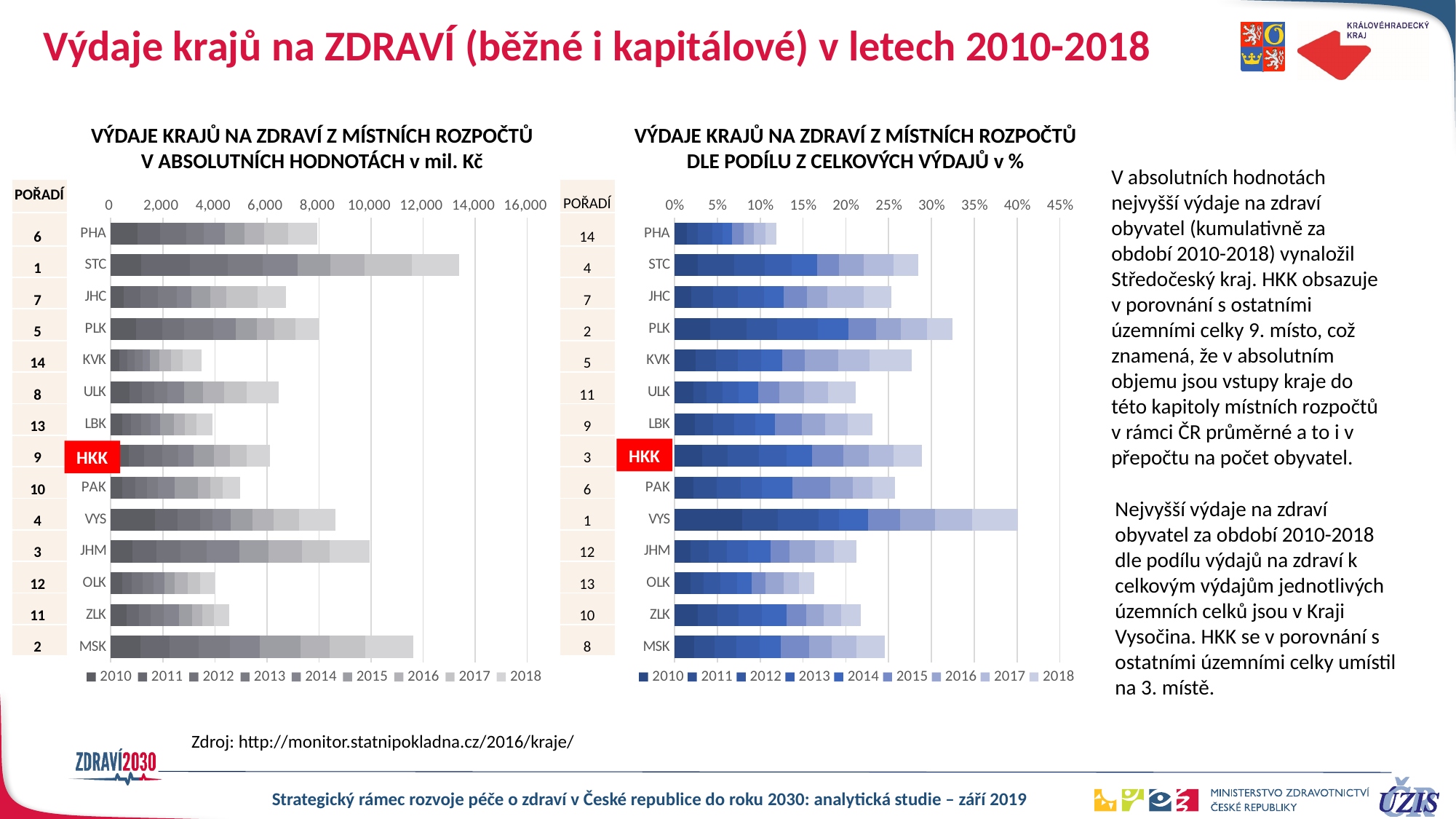
In the left chart (absolute values in mil. Kč), which region has the lowest total expenditure? KVK How many regions (categories) are plotted in the left chart (absolute values in mil. Kč)? 14 According to the POŘADÍ column next to the right chart (share of total expenditure in %), what rank does HKK hold? 3 How many series does the legend of the right chart (share of total expenditure in %) list? 9 In the left chart (absolute values in mil. Kč), is the total for HKK greater or less than 8,000? less In the left chart (absolute values in mil. Kč), which region has the highest total expenditure? STC In the right chart (share of total expenditure in %), which region has the lowest total? PHA In the left chart (absolute values in mil. Kč), which region has the larger total, STC or MSK? STC In the right chart (share of total expenditure in %), is the total for VYS greater or less than 35%? greater What kind of chart is the left chart, 'VÝDAJE KRAJŮ NA ZDRAVÍ Z MÍSTNÍCH ROZPOČTŮ V ABSOLUTNÍCH HODNOTÁCH v mil. Kč'? Stacked bar chart In the right chart (share of total expenditure in %), which region has the highest total? VYS In the left chart (absolute values in mil. Kč), is the total for STC greater or less than 12,000? greater